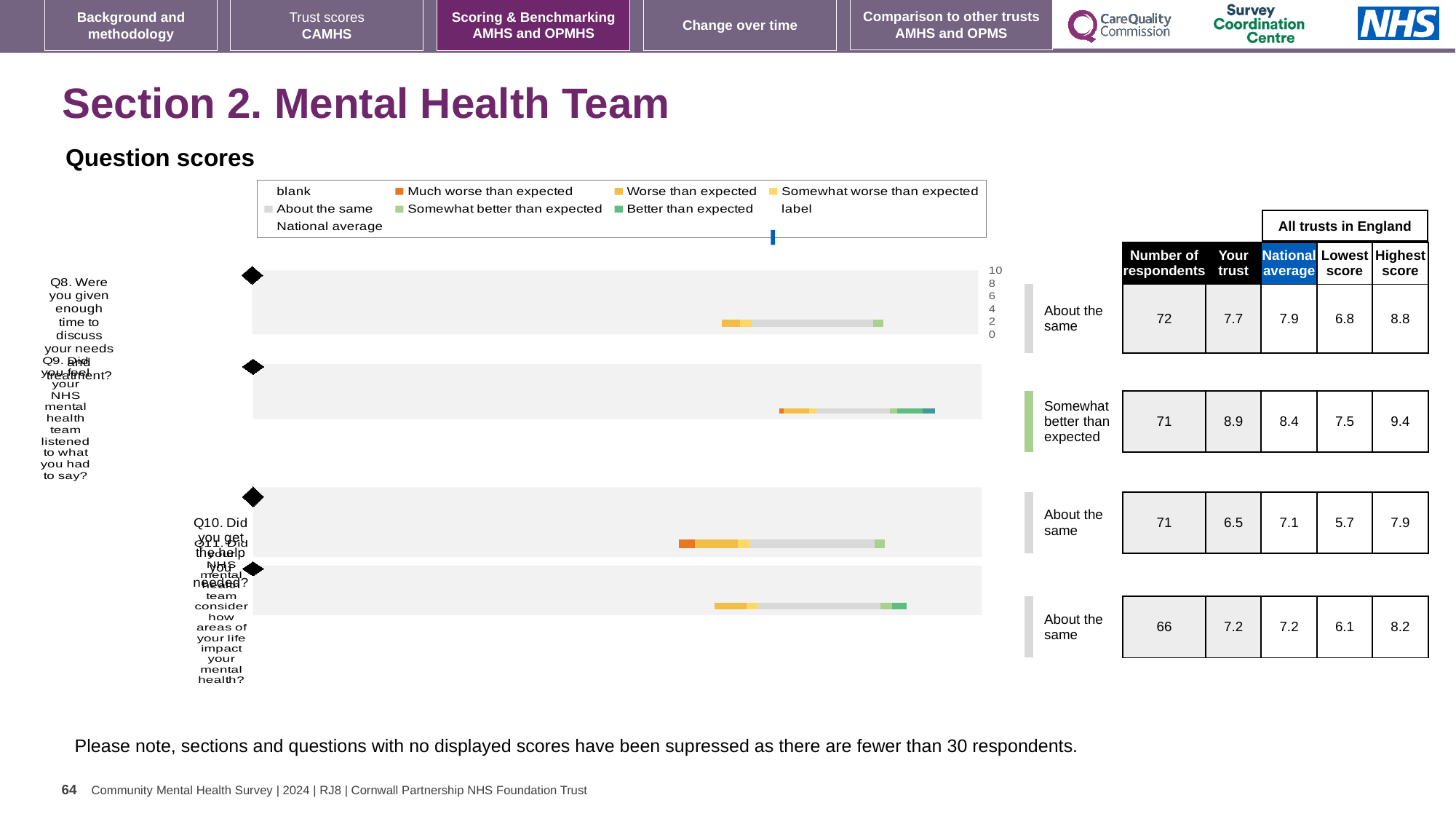
What benchmark category is shown for Q9? Somewhat better than expected How many questions are plotted in the chart? 4 What is the lowest score among all trusts in England for Q8? 6.8 What is the 'Your trust' score for Q8 (Were you given enough time to discuss your needs and treatment?)? 7.7 For Q8, which is larger: the 'Your trust' score or the national average? National average How many respondents answered Q11 (Did your NHS mental health team consider how areas of your life impact your mental health?)? 66 For Q9, what is the difference between the 'Your trust' score and the national average? 0.5 Which question has the lowest 'Your trust' score? Q10 What is the highest score among all trusts in England for Q10 (Did you get the help you needed?)? 7.9 What is the national average score for Q9 (Did you feel your NHS mental health team listened to what you had to say?)? 8.4 Which question has the highest 'Your trust' score? Q9 What kind of chart is used to show the question scores? Bar chart